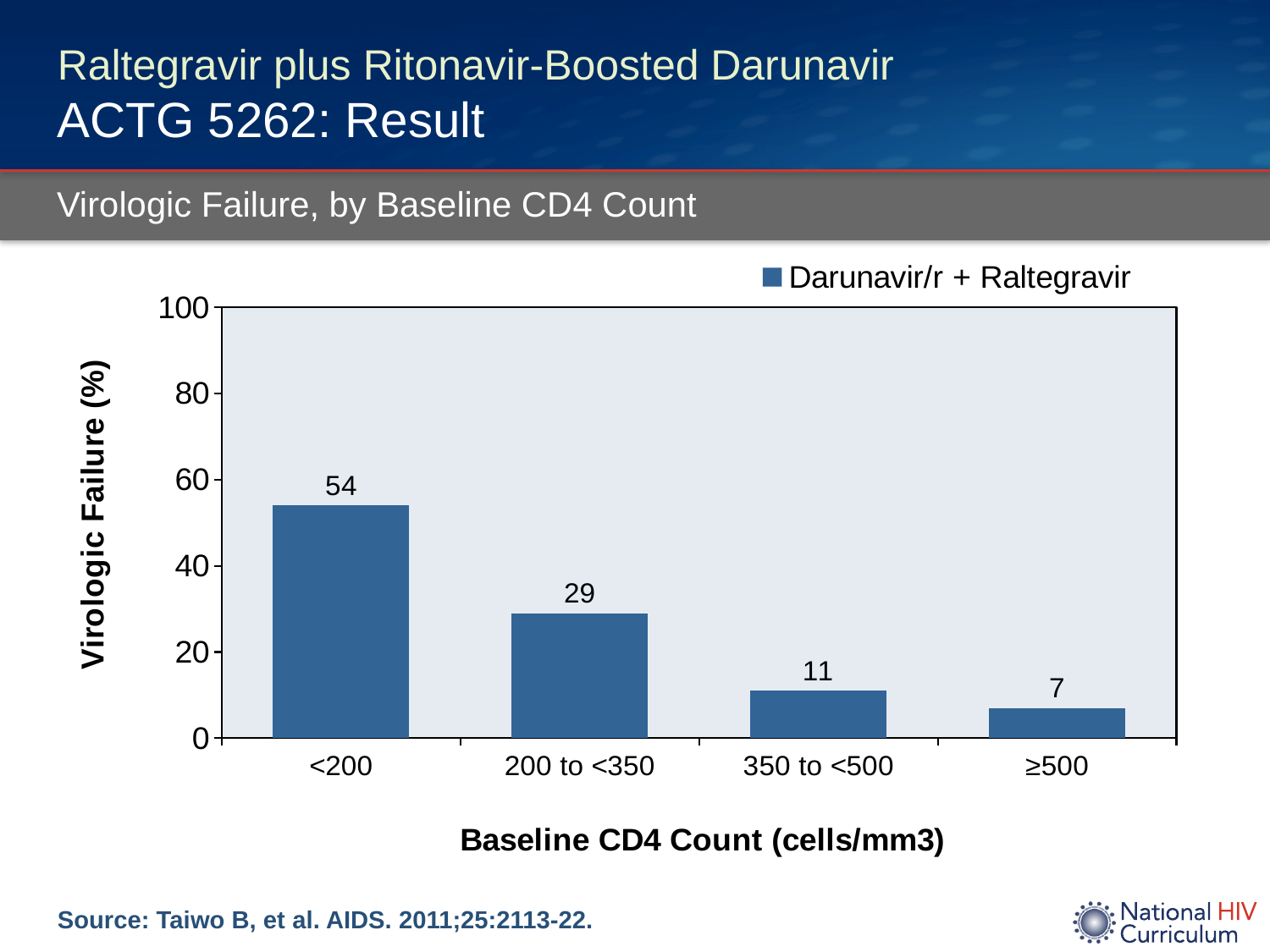
Which baseline CD4 count group has the highest virologic failure? <200 What is the virologic failure percentage for the 200 to <350 baseline CD4 count group? 29 What is the virologic failure percentage for the <200 baseline CD4 count group? 54 What is the difference in virologic failure between the 350 to <500 group and the ≥500 group? 4 Does virologic failure rise or fall as baseline CD4 count increases along the x axis? Fall Which group has a higher virologic failure rate, 200 to <350 or 350 to <500? 200 to <350 Which baseline CD4 count group has the lowest virologic failure? ≥500 What is the virologic failure percentage for the ≥500 baseline CD4 count group? 7 What kind of chart is shown on the slide? Bar chart How many baseline CD4 count categories are shown on the chart? 4 What is the difference in virologic failure between the <200 group and the 200 to <350 group? 25 How many series does the legend list? 1